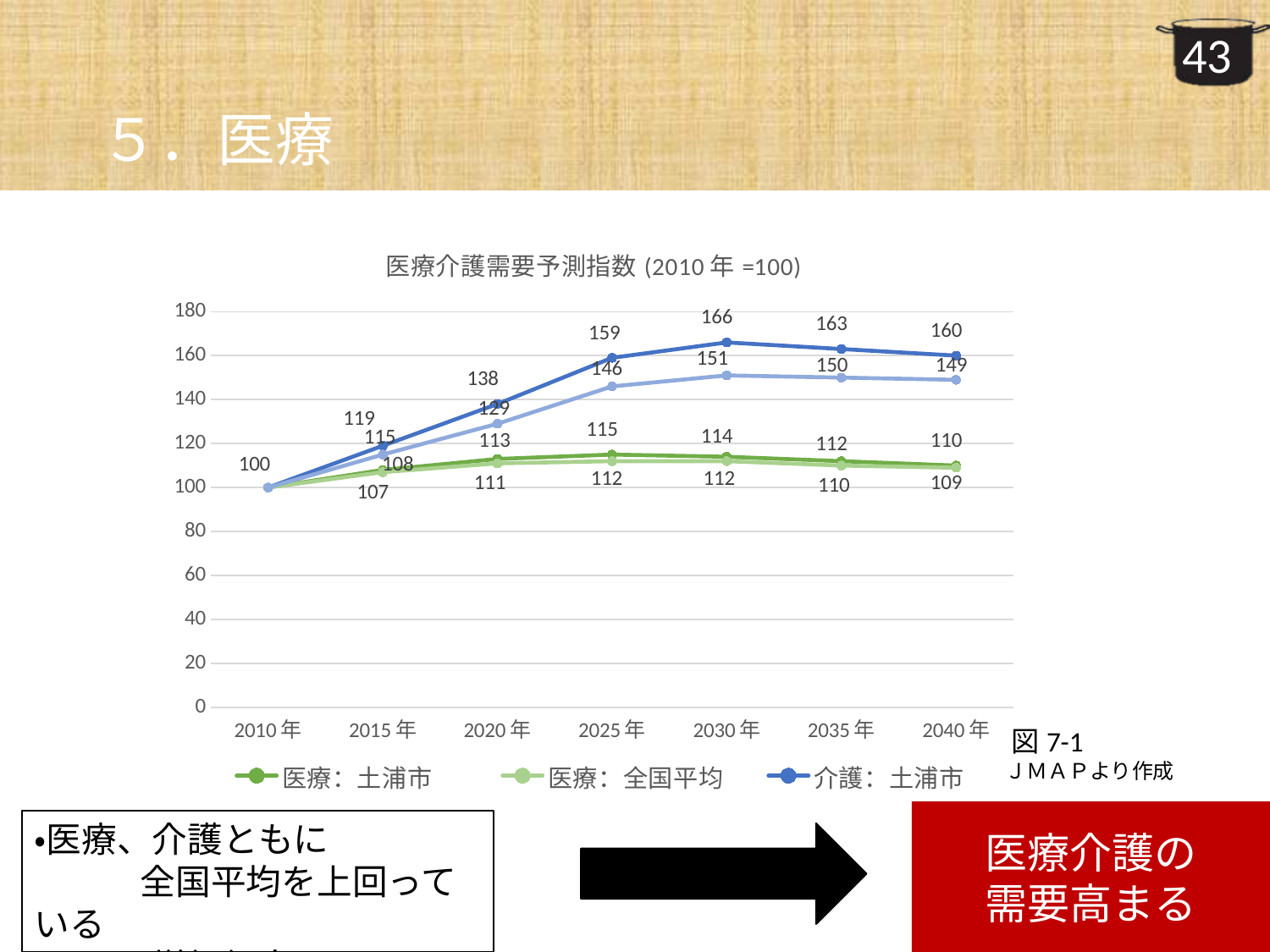
In 2040年, which is larger: 医療: 土浦市 or 医療: 全国平均? 医療: 土浦市 Does 医療: 土浦市 rise or fall from 2025年 to 2040年? fall What is the value of 医療: 全国平均 in 2040年? 109 What is the difference between 介護: 土浦市 and 医療: 土浦市 in 2025年? 44 What is the value of 医療: 土浦市 in 2025年? 115 What kind of chart is shown on the slide? line chart By how much does 介護: 土浦市 increase from 2010年 to 2030年? 66 What is the title of the chart? 医療介護需要予測指数 (2010年=100) What is the value of 介護: 土浦市 in 2030年? 166 How many series does the chart legend list? 3 In which year does 介護: 土浦市 reach its highest value? 2030年 How many years are shown on the x axis of the chart? 7